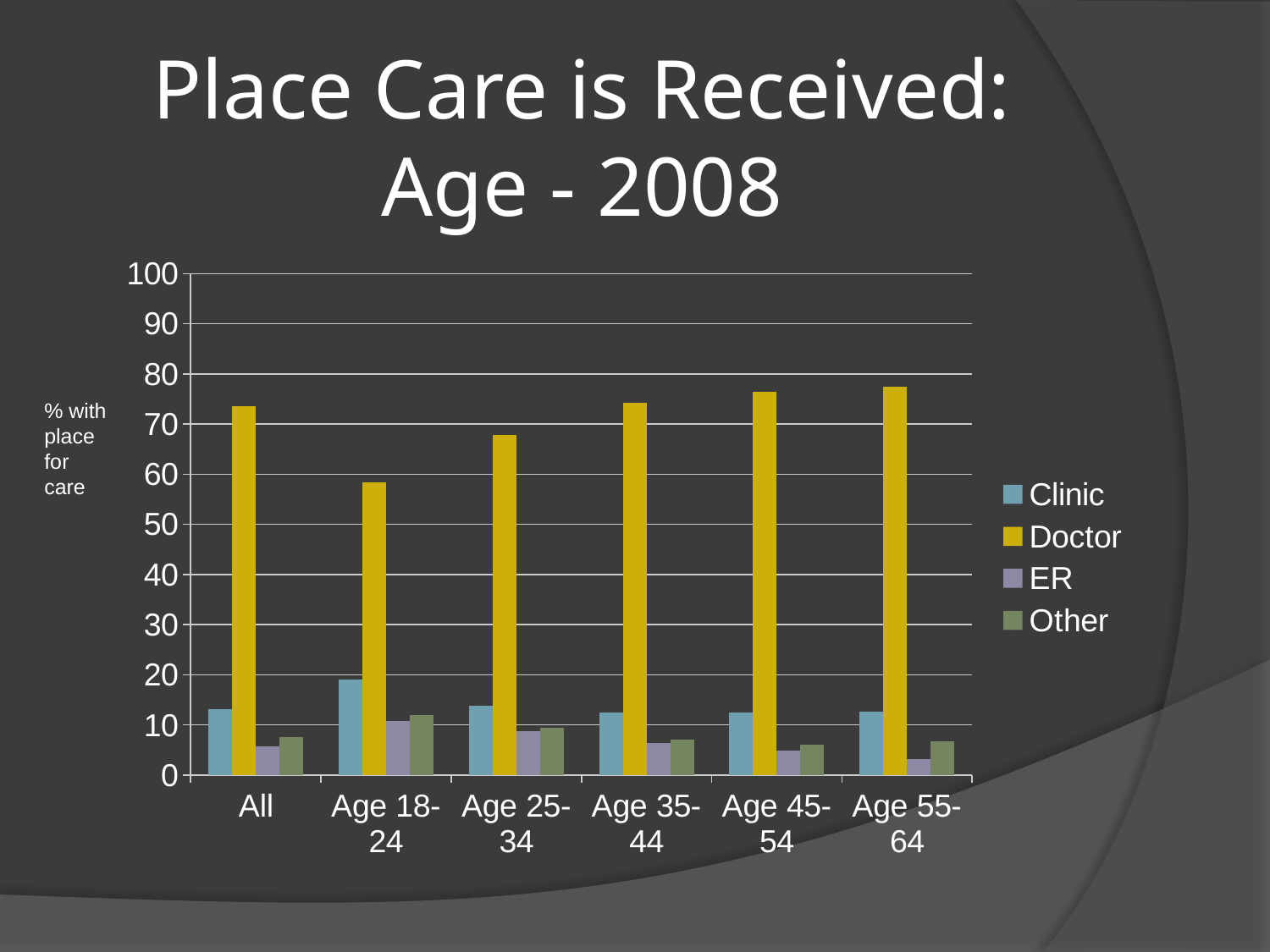
Which category has the highest ER value? Age 18-24 Is the Doctor value for Age 18-24 greater or less than 50? greater Is the Doctor value for All greater or less than 70? greater What kind of chart is shown on the slide? bar chart Is the ER value for Age 55-64 greater or less than 10? less Which category has the lowest Doctor value? Age 18-24 How many age categories are shown on the x axis? 5 Does the Doctor value rise or fall from Age 18-24 to Age 55-64? rise Which category has the highest Clinic value? Age 18-24 How many series does the legend list? 4 For the All category, which is larger, the Doctor value or the Clinic value? Doctor